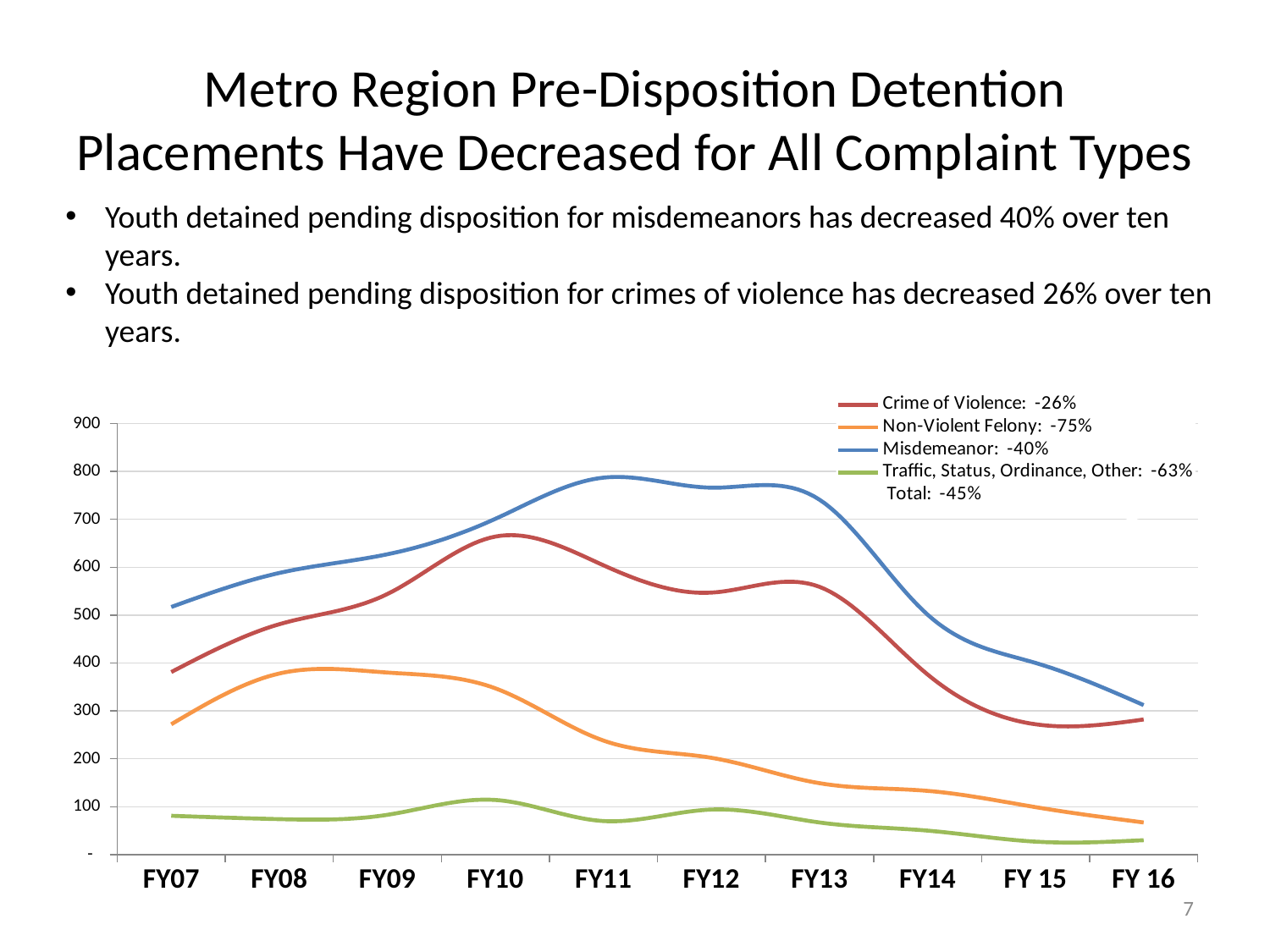
Is the Misdemeanor value for FY07 greater or less than 500? greater In FY10, which is larger: the Misdemeanor value or the Crime of Violence value? Misdemeanor What percentage change does the legend show for Non-Violent Felony? -75% How many fiscal years are shown on the x axis of the chart? 10 In which fiscal year does the Misdemeanor line reach its highest point? FY11 How many entries does the chart legend list? 5 Is the Crime of Violence value for FY 16 greater or less than 300? less Which series has the lowest values across the whole chart? Traffic, Status, Ordinance, Other What percentage change does the legend show for Total? -45% What kind of chart is shown on the slide? line chart Does the Non-Violent Felony line rise or fall from FY08 to FY 16? fall Is the Non-Violent Felony value for FY 16 greater or less than 100? less